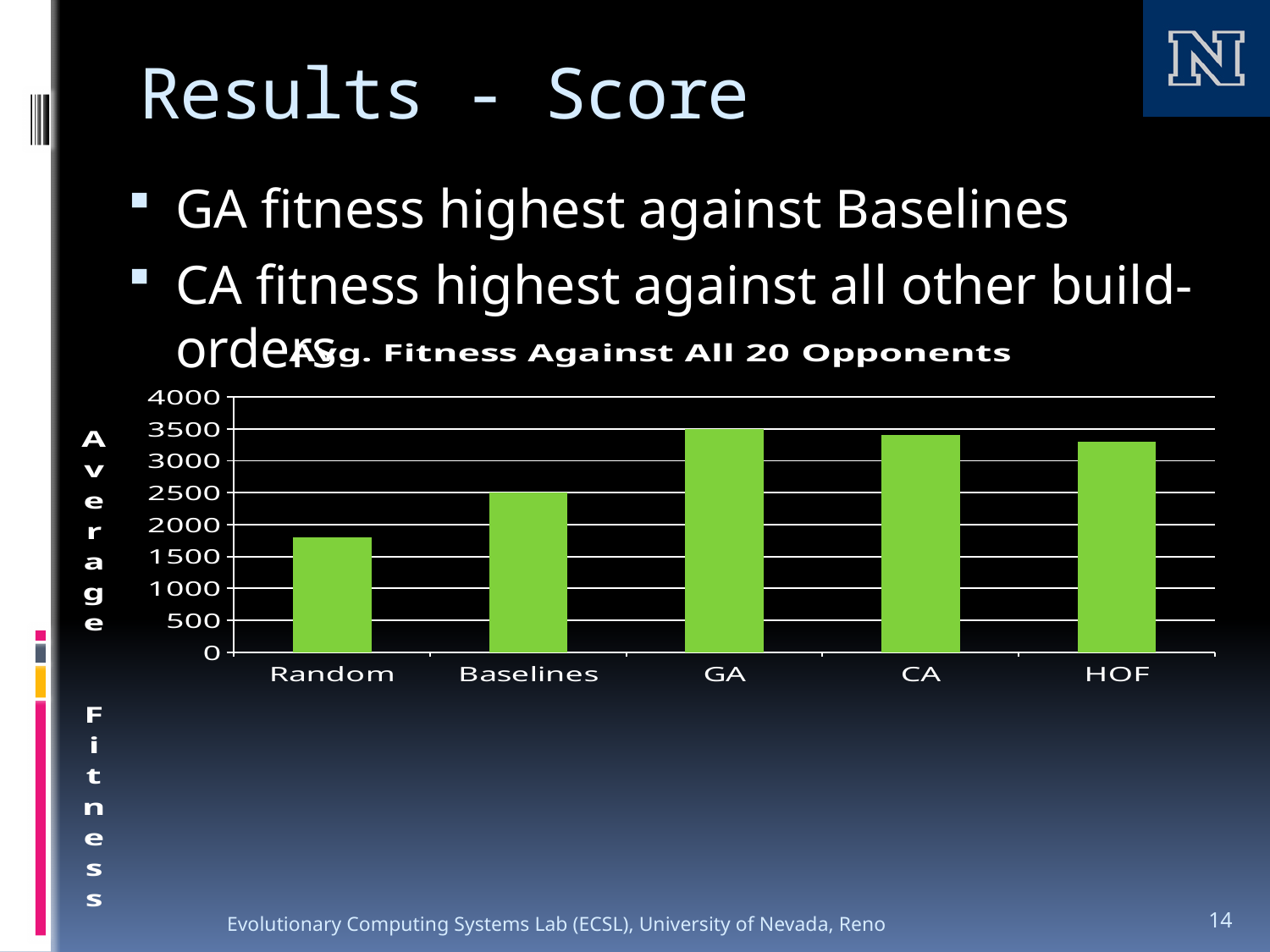
Which category has the lowest average fitness in the chart? Random Is the value for CA greater or less than 3000? greater How many categories are shown on the x axis of the chart? 5 Is the value for HOF greater or less than 3500? less Which is larger, the value for Random or the value for Baselines? Baselines Is the value for Random greater or less than 2000? less What is the title of the chart? Avg. Fitness Against All 20 Opponents What type of chart is shown on the slide? bar chart What is the label on the vertical axis of the chart? Average Fitness Which category has the highest average fitness in the chart? GA Which is larger, the value for GA or the value for HOF? GA